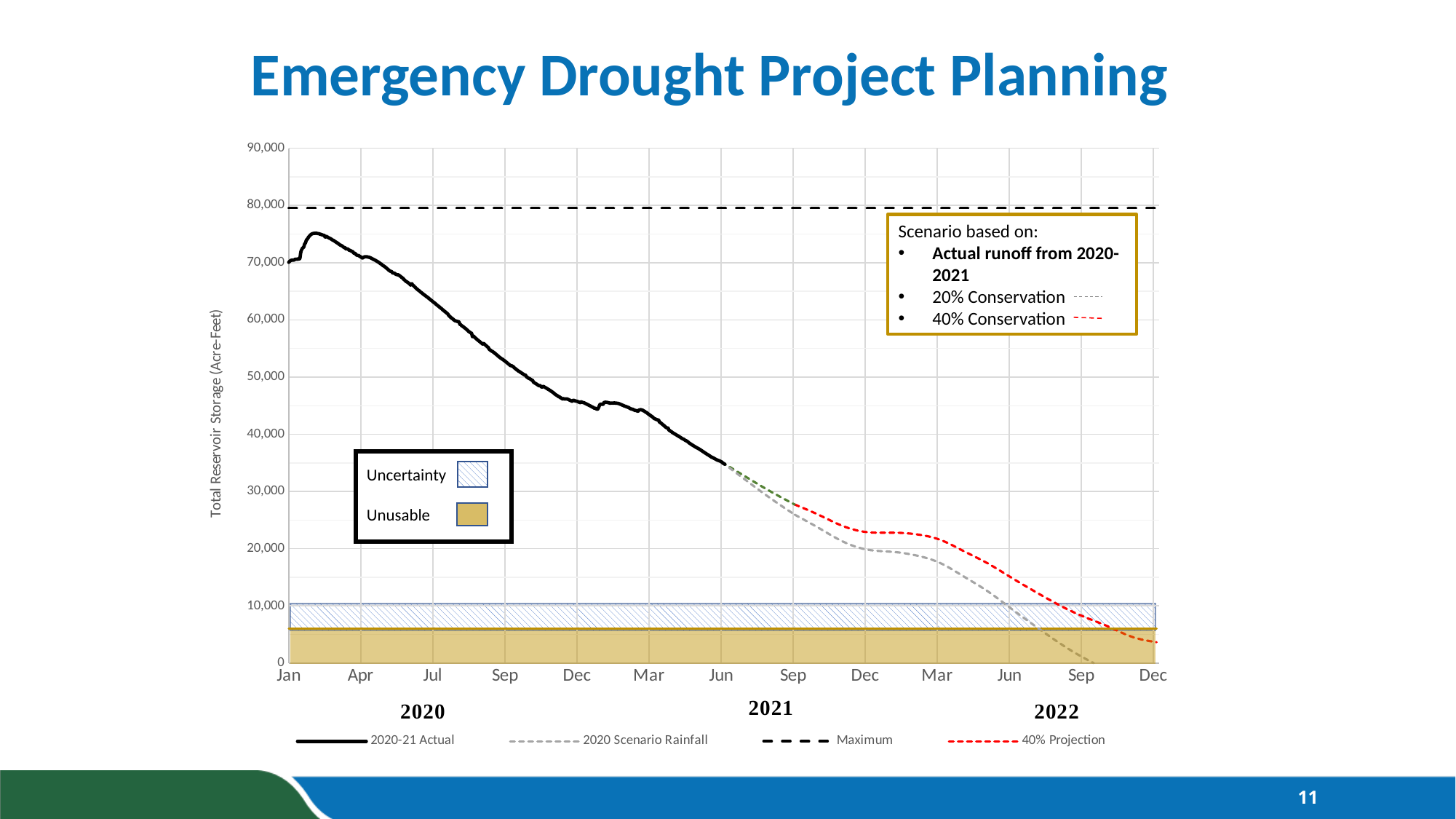
Is the Maximum line greater or less than 70,000? greater What is the label of the vertical axis? Total Reservoir Storage (Acre-Feet) Does the 2020-21 Actual line generally rise or fall from Apr 2020 to Jun 2021? fall How many series does the legend at the bottom of the chart list? 4 Is the value of the 2020-21 Actual line at Jun 2021 greater or less than 30,000? greater Is the value of the 2020-21 Actual line at Jun 2021 greater or less than 40,000? less At Sep 2022, which is higher: the 40% Projection line or the 2020 Scenario Rainfall line? 40% Projection What kind of chart is shown on the slide? line chart What is the title of the slide containing the chart? Emergency Drought Project Planning